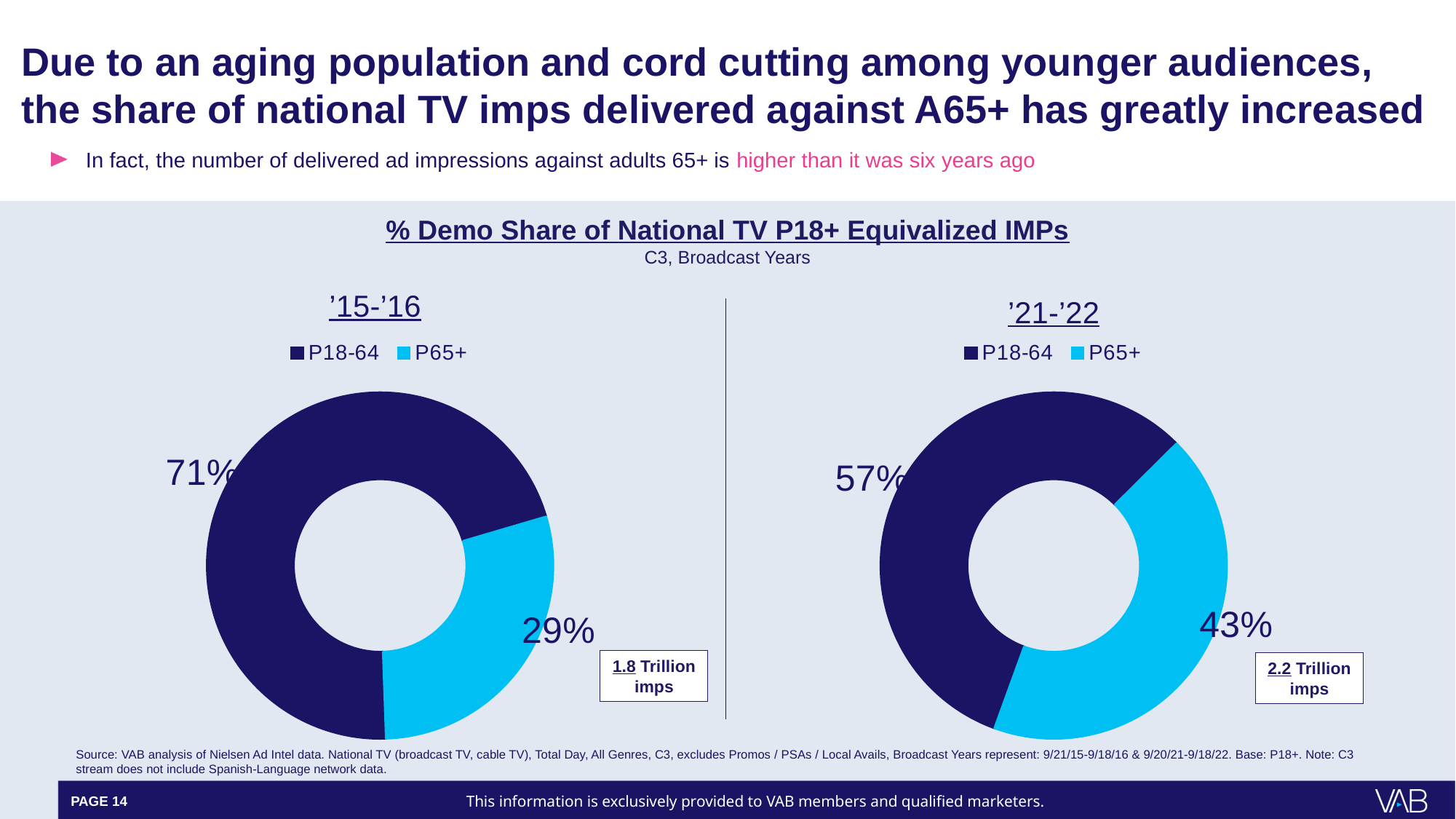
What total number of impressions is noted next to the '21-'22 chart? 2.2 Trillion imps In the '15-'16 chart, what is the difference between the P18-64 share and the P65+ share? 42 percentage points In the '15-'16 chart, what share of national TV P18+ equivalized IMPs went to P65+? 29% In the '15-'16 chart, which demo has the smaller share? P65+ How many series does the legend of the '21-'22 chart list? 2 In the '21-'22 chart, what is the share for P65+? 43% By how many percentage points did the P65+ share increase from the '15-'16 chart to the '21-'22 chart? 14 percentage points Is the P65+ share larger in the '15-'16 chart or the '21-'22 chart? '21-'22 What kind of chart is used to show the '15-'16 demo shares? Doughnut (pie) chart In the '15-'16 chart, what is the share for P18-64? 71% In the '21-'22 chart, what share of national TV P18+ equivalized IMPs went to P18-64? 57% In the '21-'22 chart, which demo has the larger share? P18-64